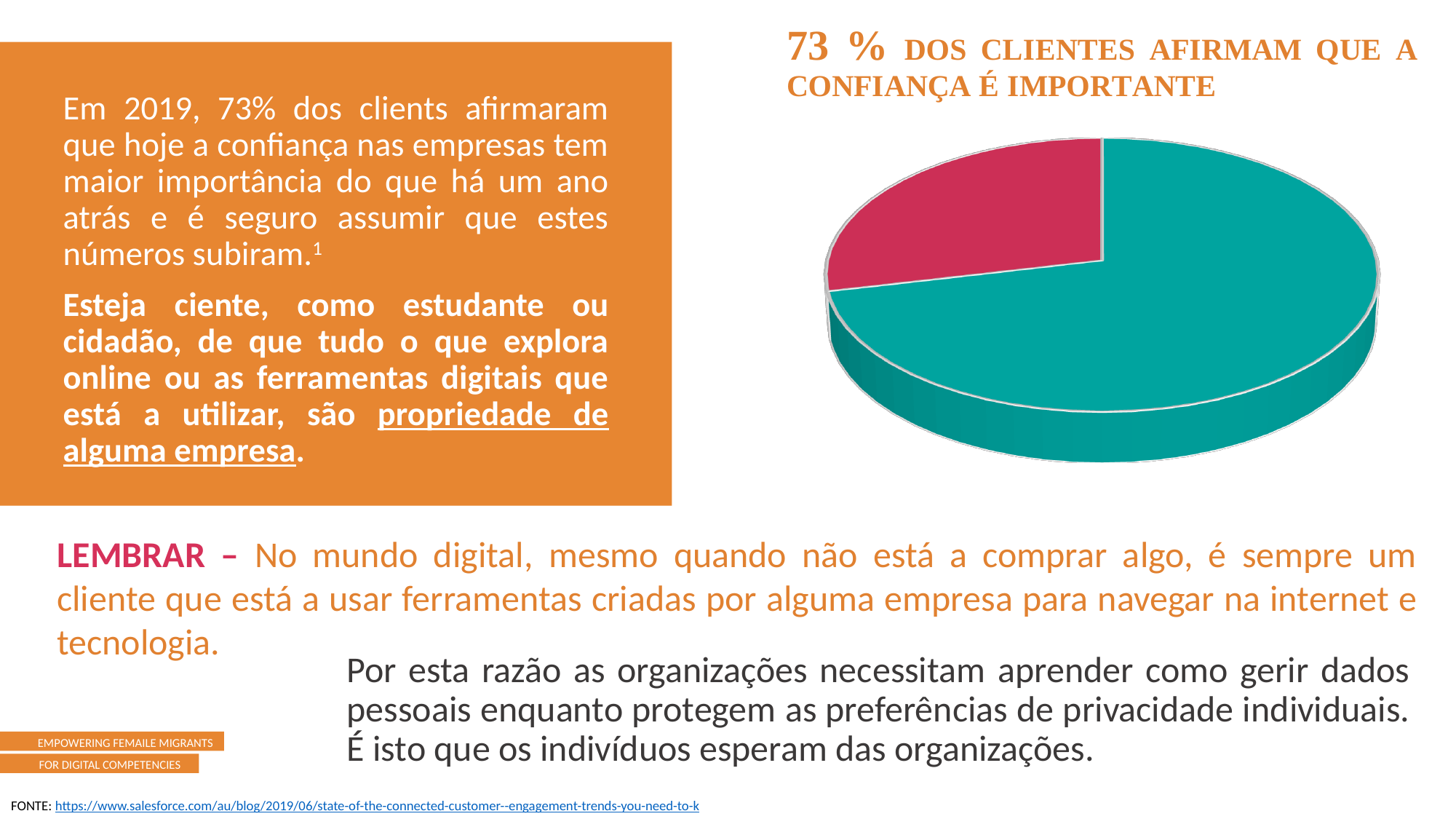
Is the teal slice of the pie chart greater or less than 50% of the pie? greater Does the pie chart display a legend? No Is the red slice of the pie chart greater or less than 50% of the pie? less Which colour is the largest slice of the pie chart? teal Which slice of the pie chart is larger, the teal one or the red one? the teal one According to the chart title, what share of clients say that trust is important? 73 % What is the title of the pie chart? 73 % DOS CLIENTES AFIRMAM QUE A CONFIANÇA É IMPORTANTE What kind of chart is shown on the slide? pie chart Which colour is the smallest slice of the pie chart? red How many slices does the pie chart have? 2